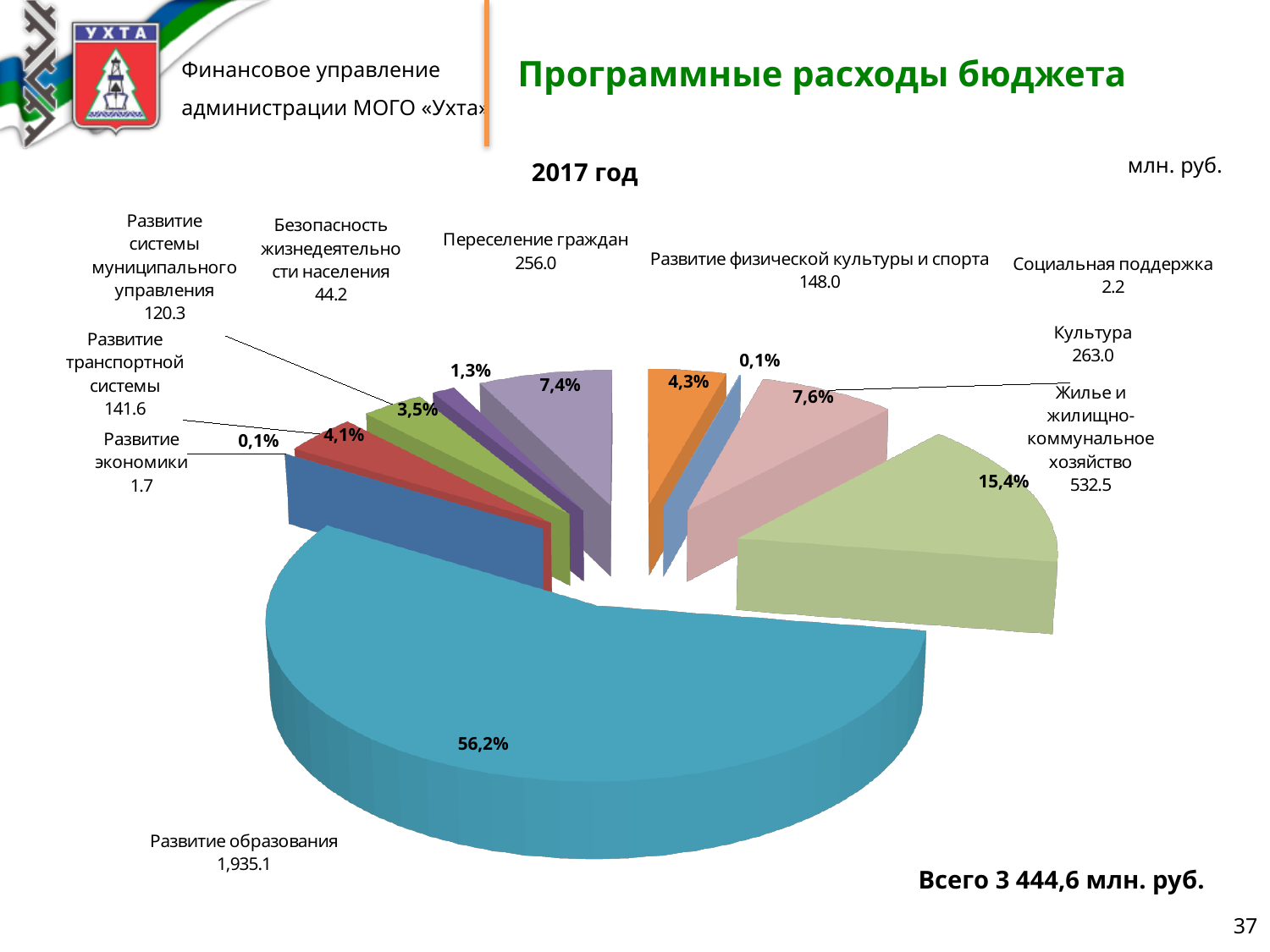
How many categories does the pie chart show? 10 What is the difference between the values for Развитие образования and Жилье и жилищно-коммунальное хозяйство? 1,402.6 Which category has the smallest value? Развитие экономики What kind of chart is shown on the slide? pie chart What total is stated on the slide for the programme expenditures? 3 444,6 млн. руб. What is the value for Развитие образования? 1,935.1 What is the value for Безопасность жизнедеятельности населения? 44.2 What is the value for Жилье и жилищно-коммунальное хозяйство? 532.5 Which is larger, the value for Культура or the value for Переселение граждан? Культура What is the value for Переселение граждан? 256.0 What share of the pie does Развитие образования represent? 56,2% Which category has the largest value? Развитие образования